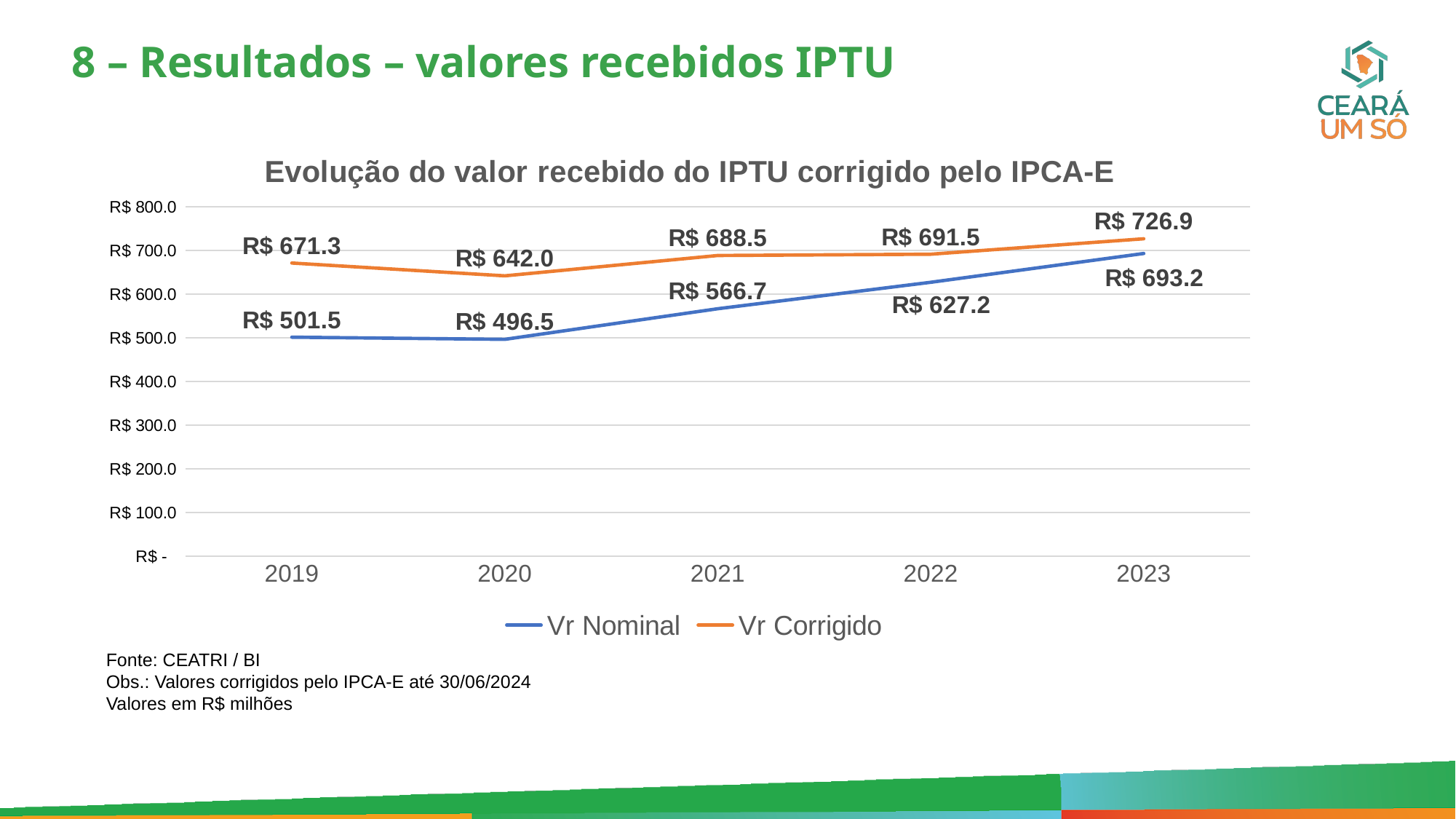
What is the Vr Corrigido value for 2020? R$ 642.0 What is the difference between the Vr Corrigido and Vr Nominal values in 2019? R$ 169.8 In which year is the Vr Nominal value the lowest? 2020 What is the Vr Nominal value for 2021? R$ 566.7 What kind of chart is shown on the slide? Line chart What is the Vr Corrigido value for 2023? R$ 726.9 Does the Vr Nominal series rise or fall from 2020 to 2023? Rise How many years are shown on the x axis? 5 In which year is the Vr Corrigido value the highest? 2023 Which is larger, the Vr Nominal value for 2023 or the Vr Corrigido value for 2020? Vr Nominal value for 2023 How many series does the legend list? 2 What is the difference between the Vr Nominal values for 2023 and 2022? R$ 66.0